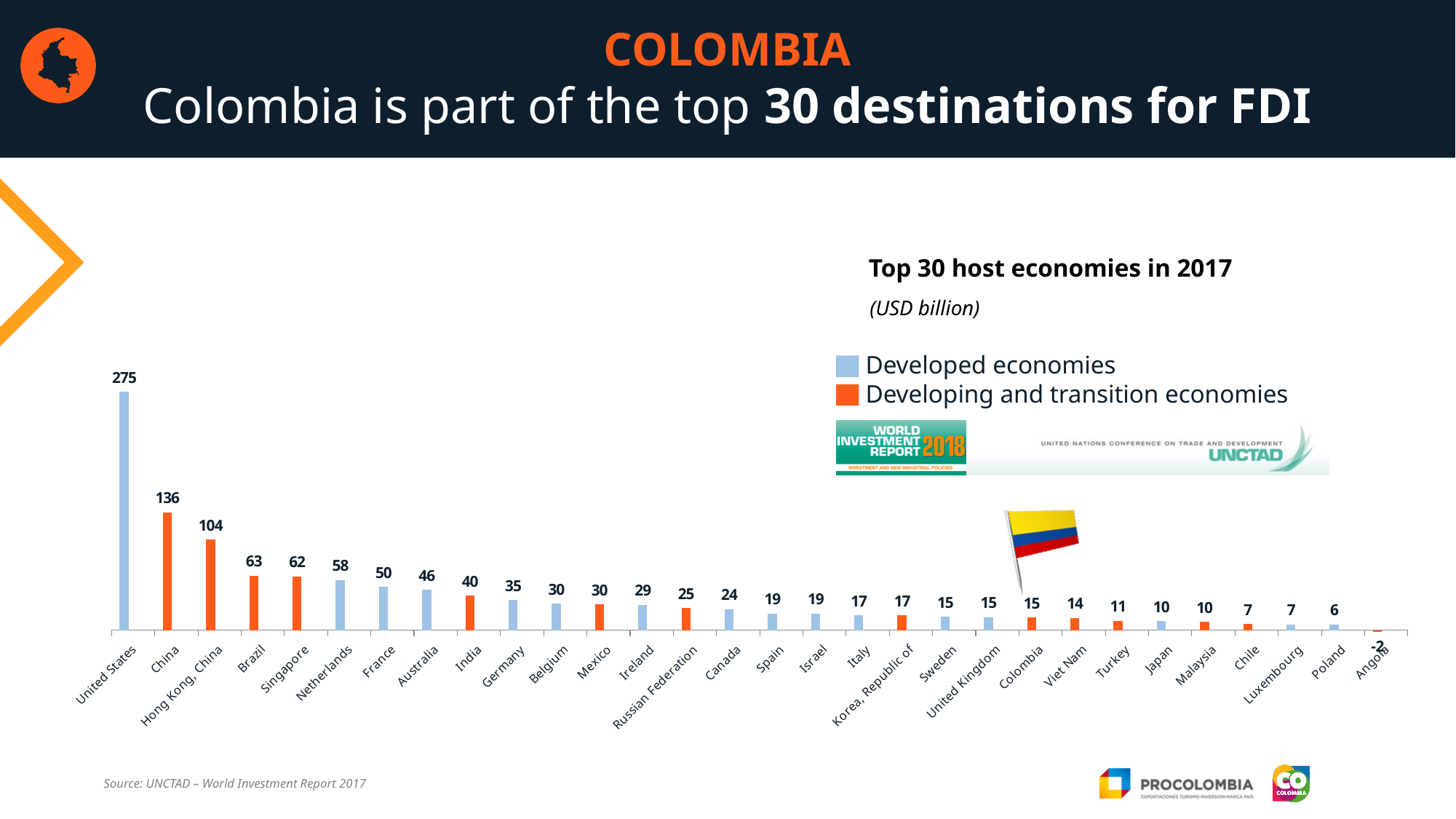
What is the difference between the values for the United States and China? 139 Which economy has the lowest value in the chart? Angola What is the value for Angola? -2 What kind of chart is shown on the slide? Bar chart What is the value for Brazil? 63 Do the values rise or fall from left to right along the x axis? Fall How many series does the legend list? 2 Which economy has the highest value in the chart? United States Which has the larger value, Brazil or Singapore? Brazil How many economies are shown in the chart? 30 What is the value for the United States? 275 What is the value for Colombia in the Top 30 host economies in 2017 chart? 15